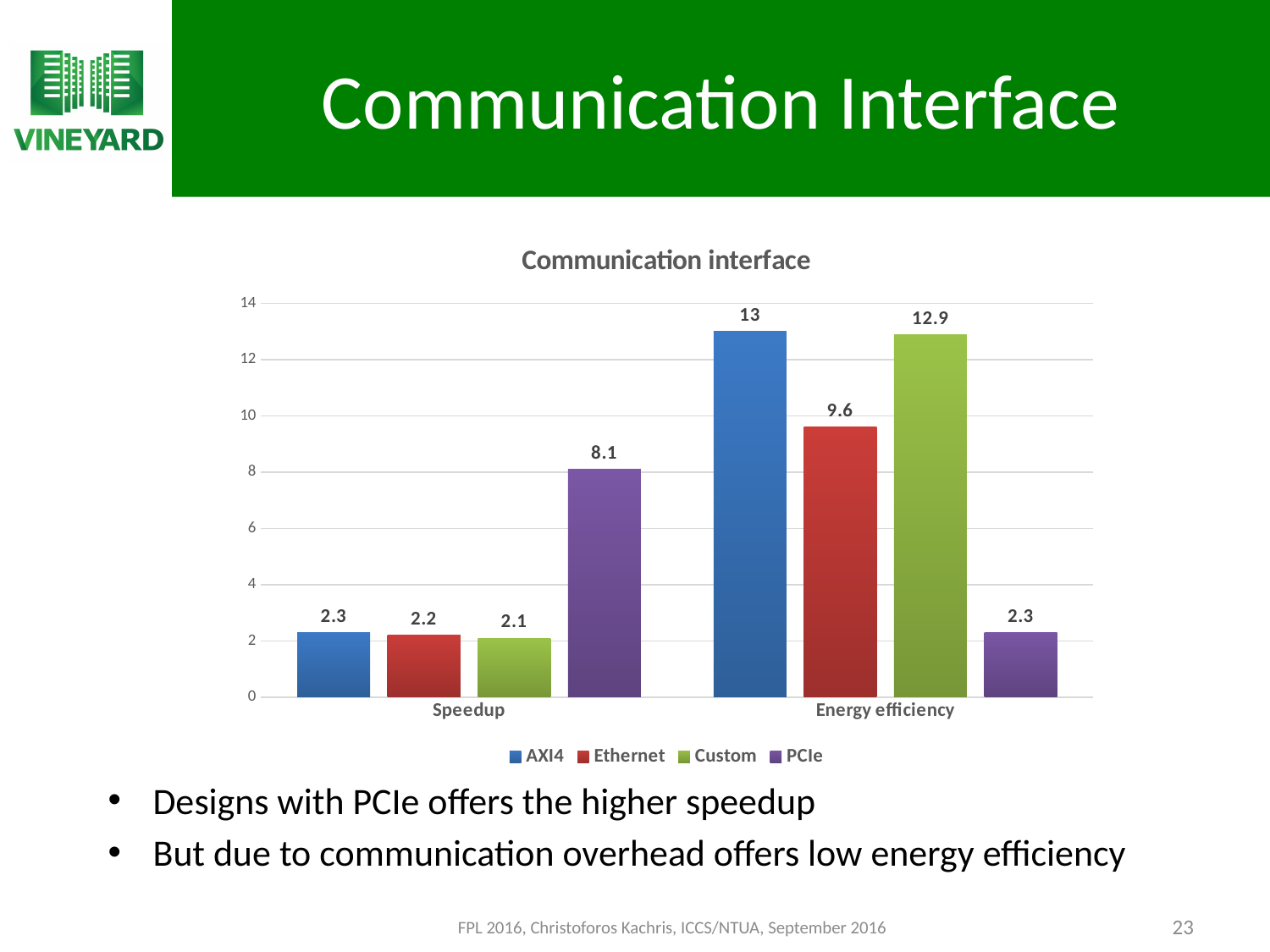
What is the Energy efficiency value for AXI4? 13 What kind of chart is shown on the slide? Bar chart How many series does the legend list? 4 What is the title of the chart? Communication interface What is the Energy efficiency value for Ethernet? 9.6 Which is larger: the Speedup for PCIe or the Speedup for AXI4? PCIe Which series has the highest Energy efficiency? AXI4 Which series has the lowest Energy efficiency? PCIe What is the Speedup value for PCIe? 8.1 What is the difference between the Energy efficiency values for AXI4 and Ethernet? 3.4 What is the Speedup value for Custom? 2.1 Which series has the highest Speedup? PCIe